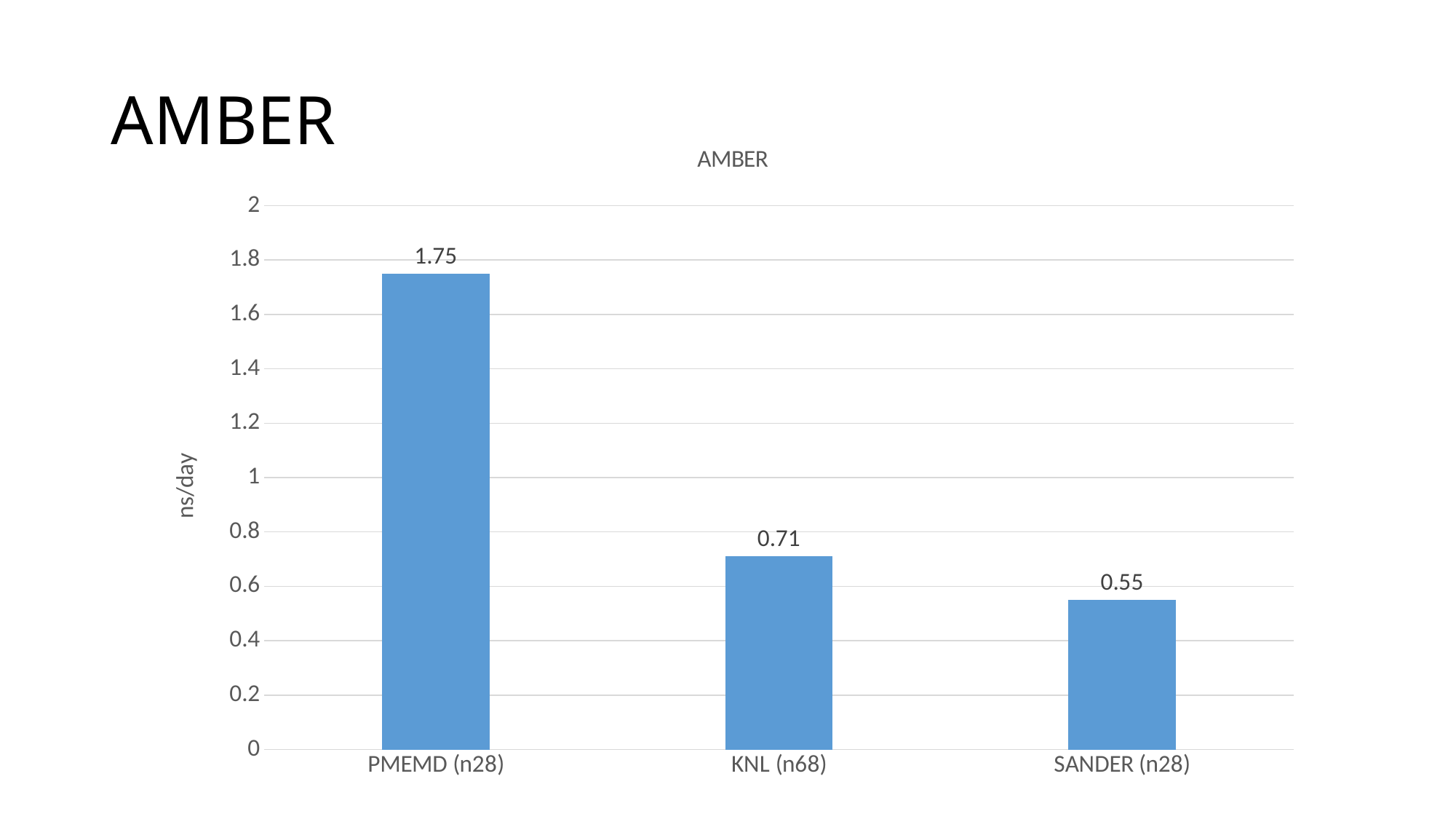
Which is larger, the value for KNL (n68) or the value for SANDER (n28)? KNL (n68) Which category has the lowest value? SANDER (n28) What is the value for SANDER (n28)? 0.55 How many categories are shown on the chart? 3 What is the label on the vertical axis of the chart? ns/day Which category has the highest value? PMEMD (n28) What is the value for KNL (n68)? 0.71 Is the value for PMEMD (n28) greater or less than 1? greater What is the difference between the values for PMEMD (n28) and KNL (n68)? 1.04 What is the value for PMEMD (n28)? 1.75 What is the difference between the values for KNL (n68) and SANDER (n28)? 0.16 What kind of chart is shown on the slide? bar chart